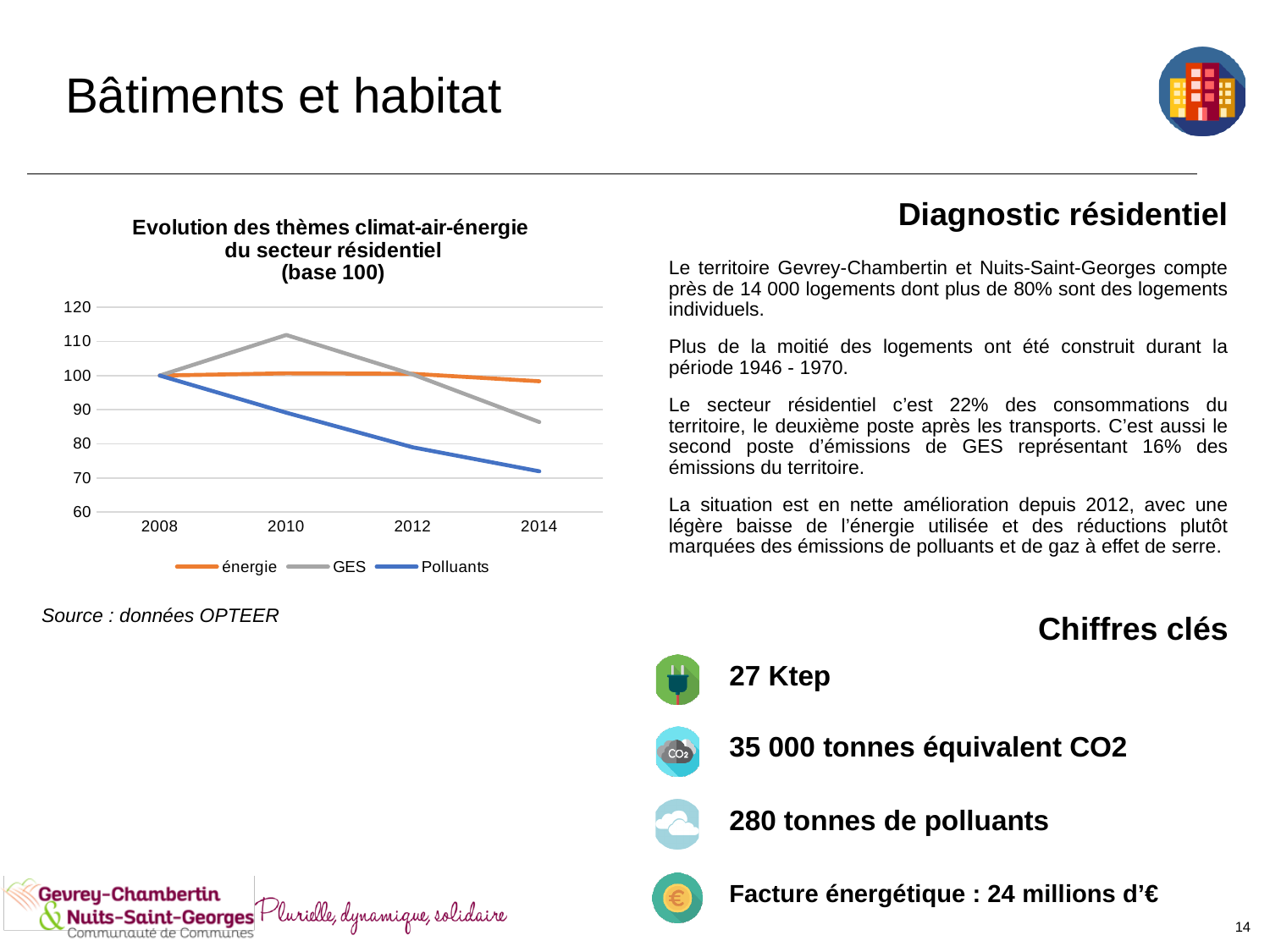
Is the value for Polluants in 2014 greater or less than 80? less How many years are shown on the x axis of the chart? 4 Which series has the highest value in 2014? énergie Does the Polluants series rise or fall from 2008 to 2014? fall Is the value for GES in 2010 greater or less than 100? greater In 2010, which is larger: GES or Polluants? GES What is the value of the Polluants series in 2008? 100 Which series has the lowest value in 2014? Polluants Is the value for GES in 2014 greater or less than 90? less How many series does the chart legend list? 3 What is the title of the chart? Evolution des thèmes climat-air-énergie du secteur résidentiel (base 100) What kind of chart is shown on the slide? line chart